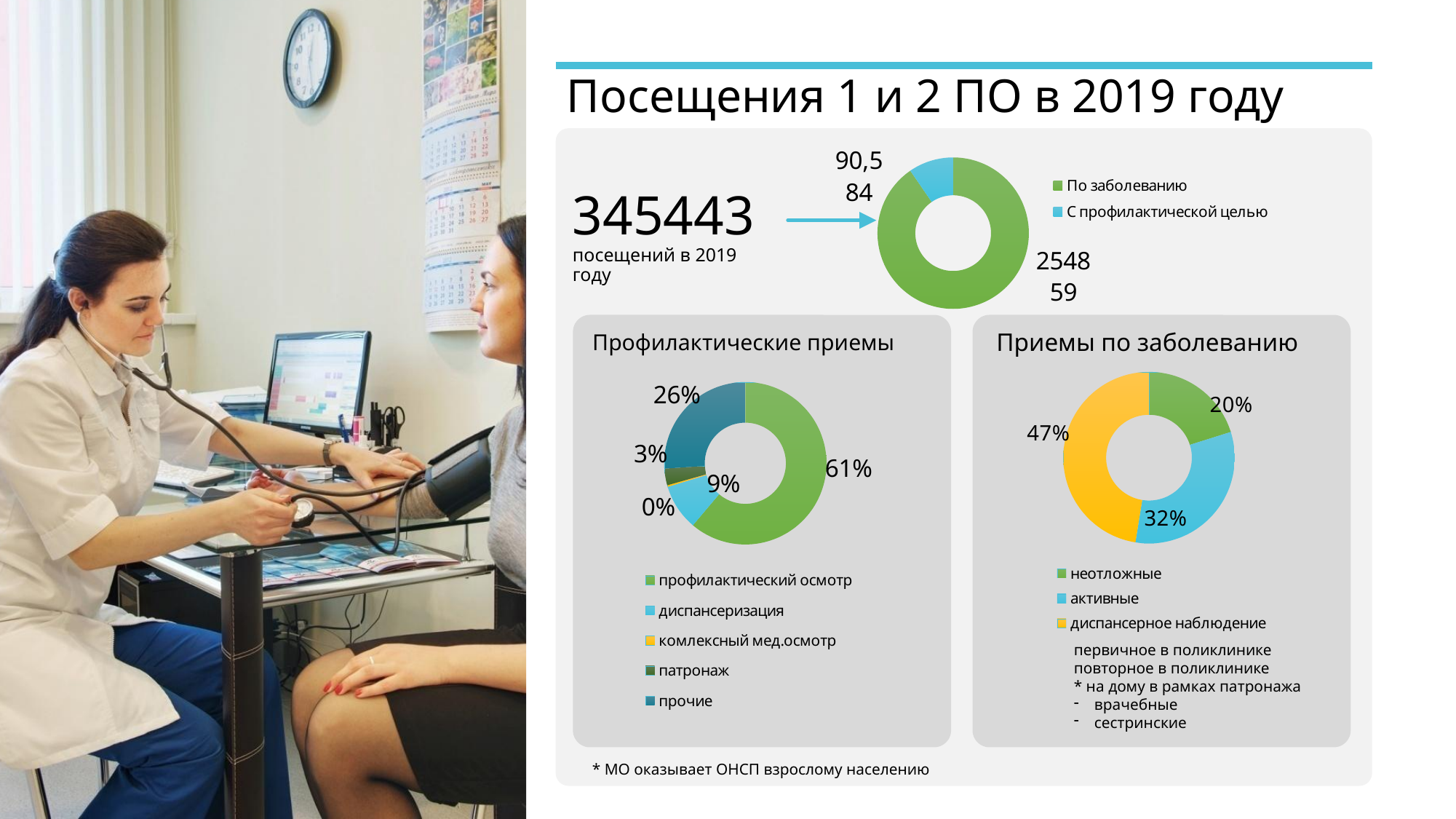
In the chart titled 'Профилактические приемы', which category has the largest share? профилактический осмотр In the chart titled 'Приемы по заболеванию', what share is labelled for 'диспансерное наблюдение'? 47% In the chart titled 'Приемы по заболеванию', what is the difference in percentage points between 'диспансерное наблюдение' and 'неотложные'? 27 In the top doughnut chart next to the number 345443, which segment is larger: 'По заболеванию' or 'С профилактической целью'? По заболеванию In the chart titled 'Приемы по заболеванию', which category has the smallest share? неотложные In the chart titled 'Профилактические приемы', what share is labelled for 'прочие'? 26% What type of chart is used for 'Приемы по заболеванию'? doughnut chart In the chart titled 'Приемы по заболеванию', what share is labelled for 'активные'? 32% In the chart titled 'Профилактические приемы', what share is labelled for 'профилактический осмотр'? 61% In the chart titled 'Профилактические приемы', which category has the smallest share? комлексный мед.осмотр In the chart titled 'Профилактические приемы', what share is labelled for 'диспансеризация'? 9% In the chart titled 'Профилактические приемы', how many categories does the legend list? 5